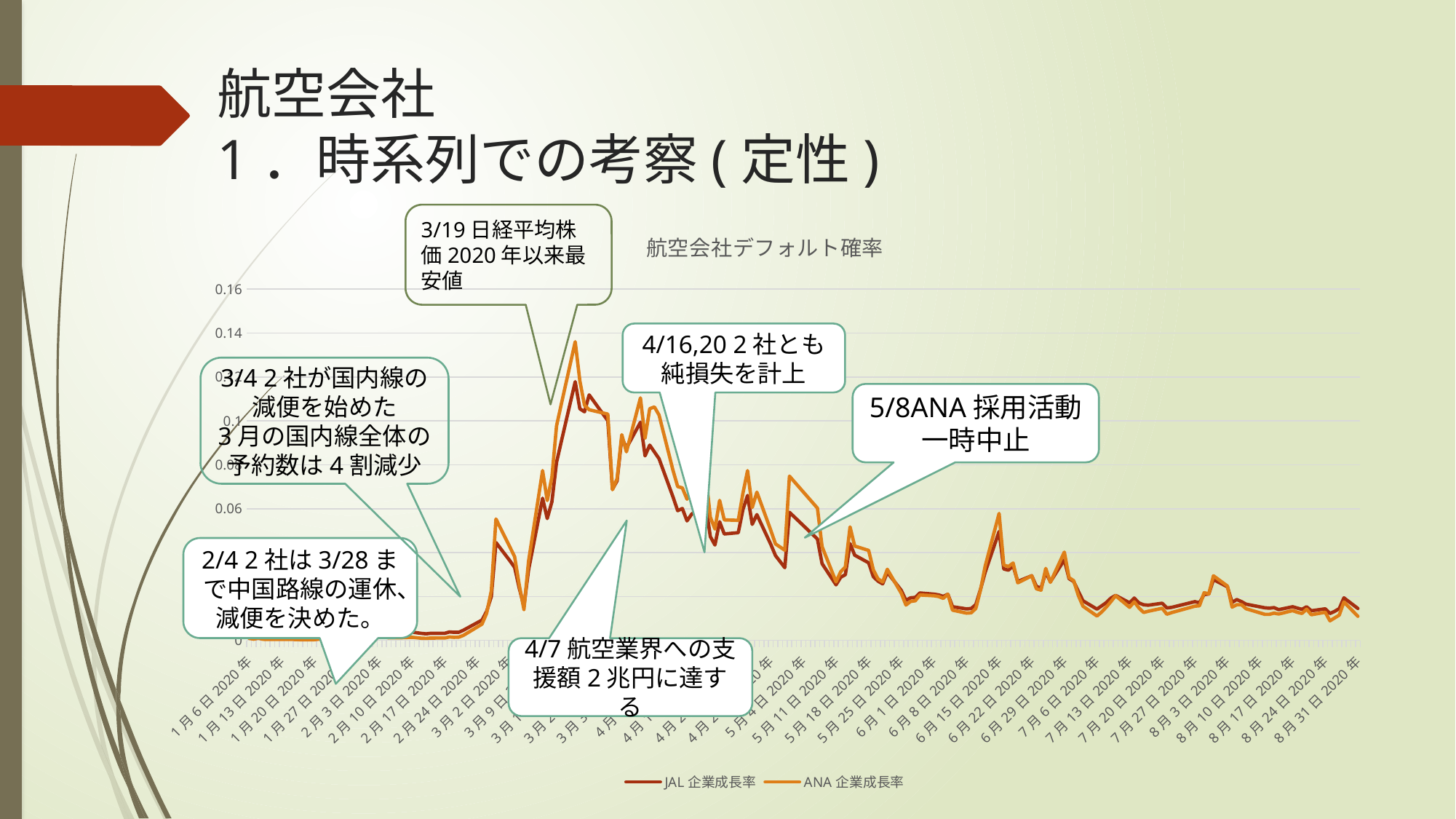
Do the values rise or fall from the March peak to the end of August? fall Is the value of JAL 企業成長率 on 1月6日2020年 greater or less than 0.06? less Is the value of ANA 企業成長率 on 8月31日2020年 greater or less than 0.06? less Do the values rise or fall from early January to mid-March? rise Which series is drawn in orange according to the legend? ANA 企業成長率 At the March peak, which series reaches the higher value, JAL 企業成長率 or ANA 企業成長率? ANA 企業成長率 What is the title of the chart? 航空会社デフォルト確率 What is the highest value shown on the vertical axis? 0.16 How many series does the legend list? 2 Is the peak value of ANA 企業成長率 greater or less than 0.12? greater What kind of chart is shown on the slide? line chart In which month of 2020 do both series reach their highest values? 3月 (March)